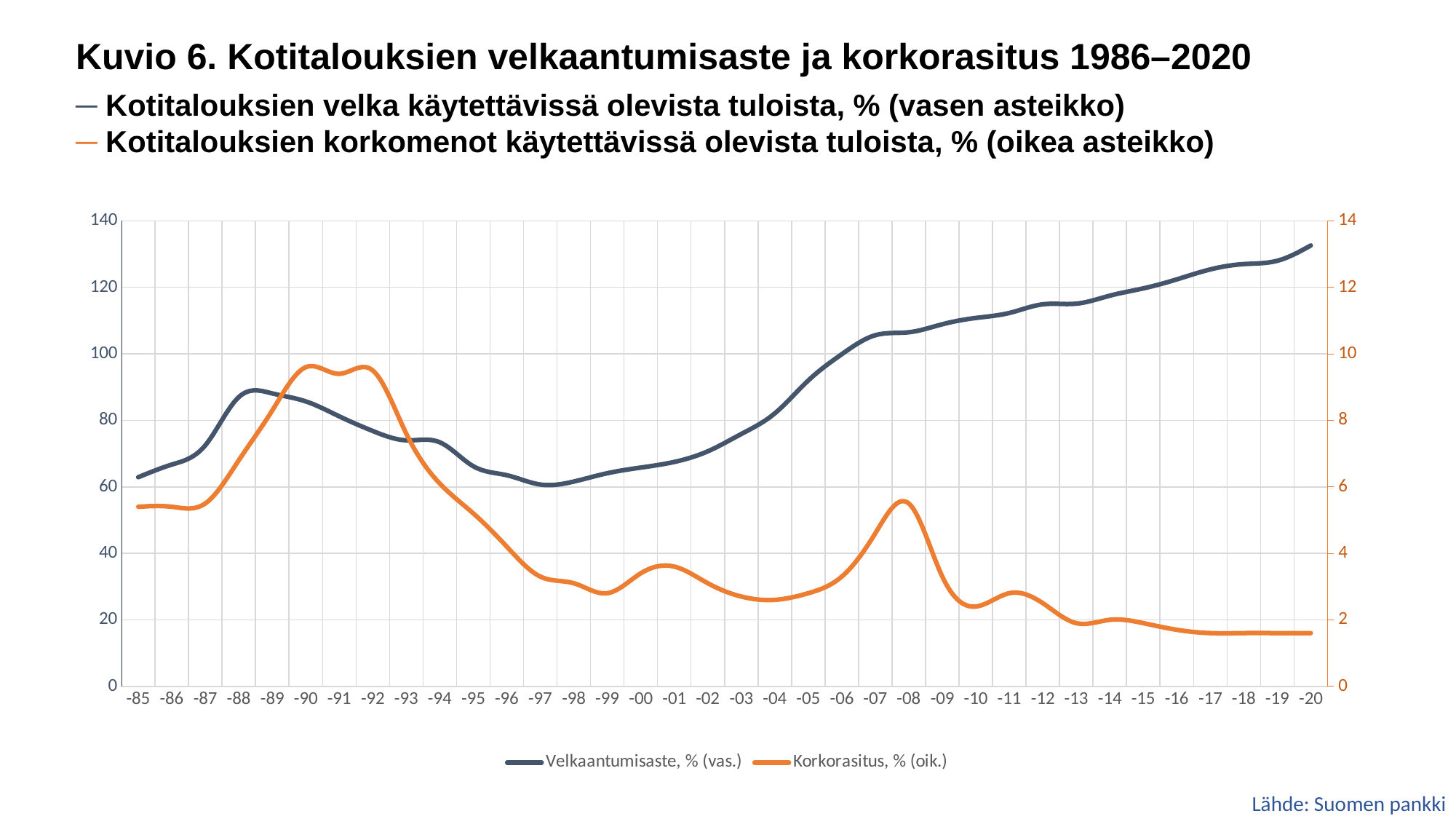
What kind of chart is shown on the slide? line chart Is the value for Korkorasitus, % (oik.) in -08 greater or less than 4? greater In which year is Velkaantumisaste, % (vas.) at its lowest? -97 How many years are marked on the x axis? 36 Is the value for Velkaantumisaste, % (vas.) in -97 greater or less than 80? less Is the value for Korkorasitus, % (oik.) in -20 greater or less than 2? less How many series does the legend list? 2 What is the source given for the chart? Suomen pankki In which year is Velkaantumisaste, % (vas.) at its highest? -20 Which is larger for Korkorasitus, % (oik.): the value in -90 or the value in -20? -90 Does Velkaantumisaste, % (vas.) rise or fall from -00 to -20? rise